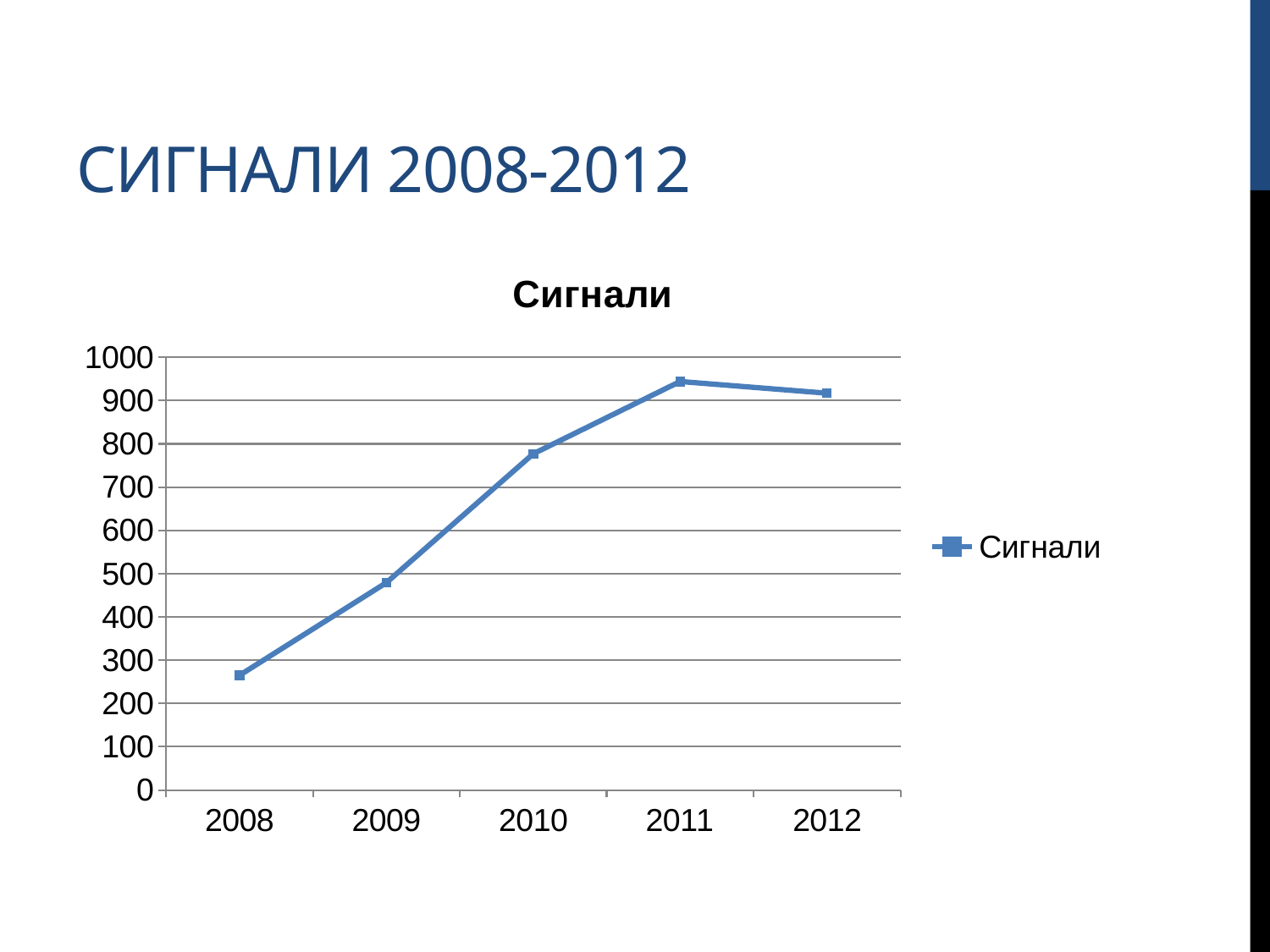
Which year has the lowest value for Сигнали? 2008 Is the value for 2008 greater or less than 300? less How many series does the legend list? 1 Do the values rise or fall from 2008 to 2011? rise How many years are plotted on the x axis of the chart? 5 What is the title of the chart? Сигнали What kind of chart is shown on the slide? line chart Which year has the larger value, 2009 or 2010? 2010 Is the value for 2009 greater or less than 500? less Is the value for 2011 greater or less than 900? greater Which year has the highest value for Сигнали? 2011